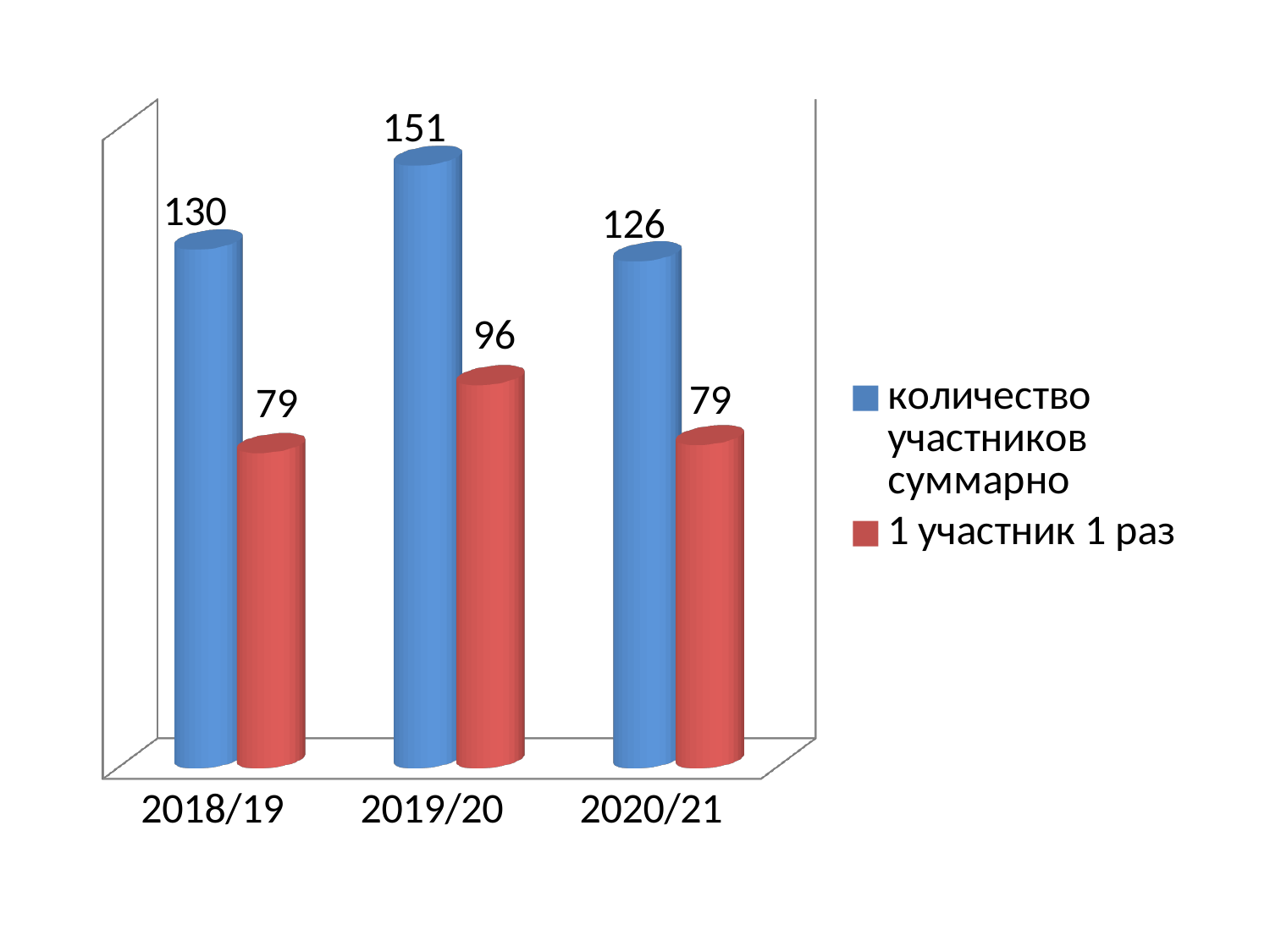
What kind of chart is shown on the slide? bar chart What is the value of "1 участник 1 раз" for 2019/20? 96 In which year is "количество участников суммарно" lowest? 2020/21 What is the difference in "количество участников суммарно" between 2019/20 and 2018/19? 21 What is the value of "1 участник 1 раз" for 2018/19? 79 What is the difference between "количество участников суммарно" and "1 участник 1 раз" in 2019/20? 55 Which is larger: "количество участников суммарно" in 2018/19 or in 2020/21? 2018/19 How many years are shown on the x axis? 3 How many series does the legend list? 2 What is the value of "количество участников суммарно" for 2020/21? 126 What is the value of "количество участников суммарно" for 2019/20? 151 In which year is "количество участников суммарно" highest? 2019/20